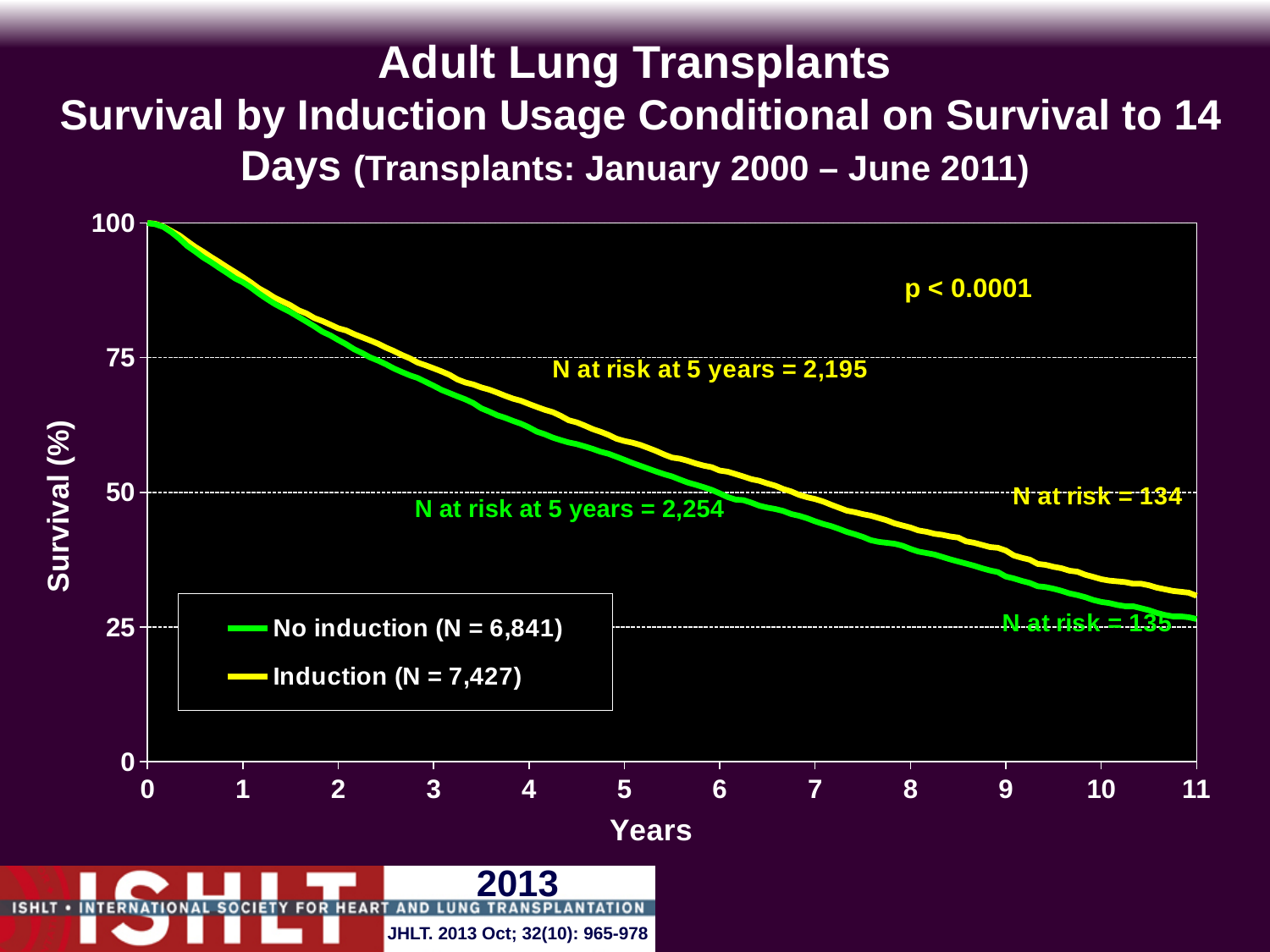
Is the survival value for the No induction curve at 3 years greater or less than 50? greater What kind of chart is shown on the slide? line chart What is the N at risk at 5 years for the No induction (green) curve? 2,254 What is the N at risk at 5 years for the Induction (yellow) curve? 2,195 What is the N for the No induction group shown in the legend? 6,841 What is the N for the Induction group shown in the legend? 7,427 Do the survival curves rise or fall as years increase? fall At 8 years, which curve shows higher survival, Induction or No induction? Induction What p-value is printed on the chart? p < 0.0001 What is the difference between the N at risk at 5 years for No induction (2,254) and Induction (2,195)? 59 Is the survival value for the Induction curve at 10 years greater or less than 50? less How many series does the legend list? 2